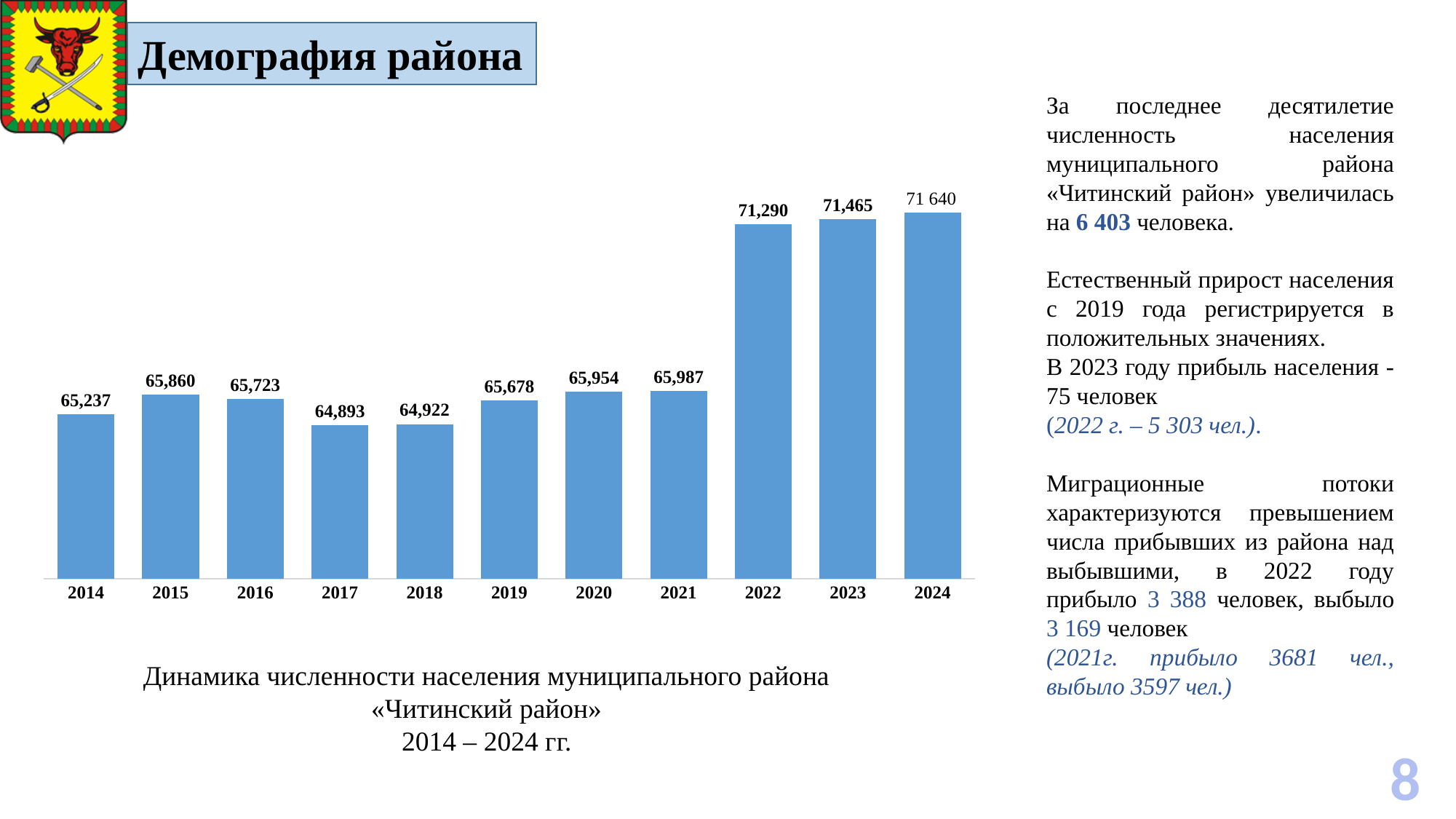
What is the population value shown for 2024? 71 640 Which year has the lowest population value on the chart? 2017 What is the population value shown for 2022? 71,290 Which year has the larger population value, 2017 or 2018? 2018 What is the difference between the population values for 2022 and 2021? 5303 How many years (bars) are shown on the chart? 11 Which year has the highest population value on the chart? 2024 What is the population value shown for 2018? 64,922 What is the difference between the population values for 2024 and 2014? 6403 Overall, do the population values rise or fall from 2014 to 2024? Rise What type of chart is used to show the population dynamics? Bar chart What is the population value shown for 2014? 65,237